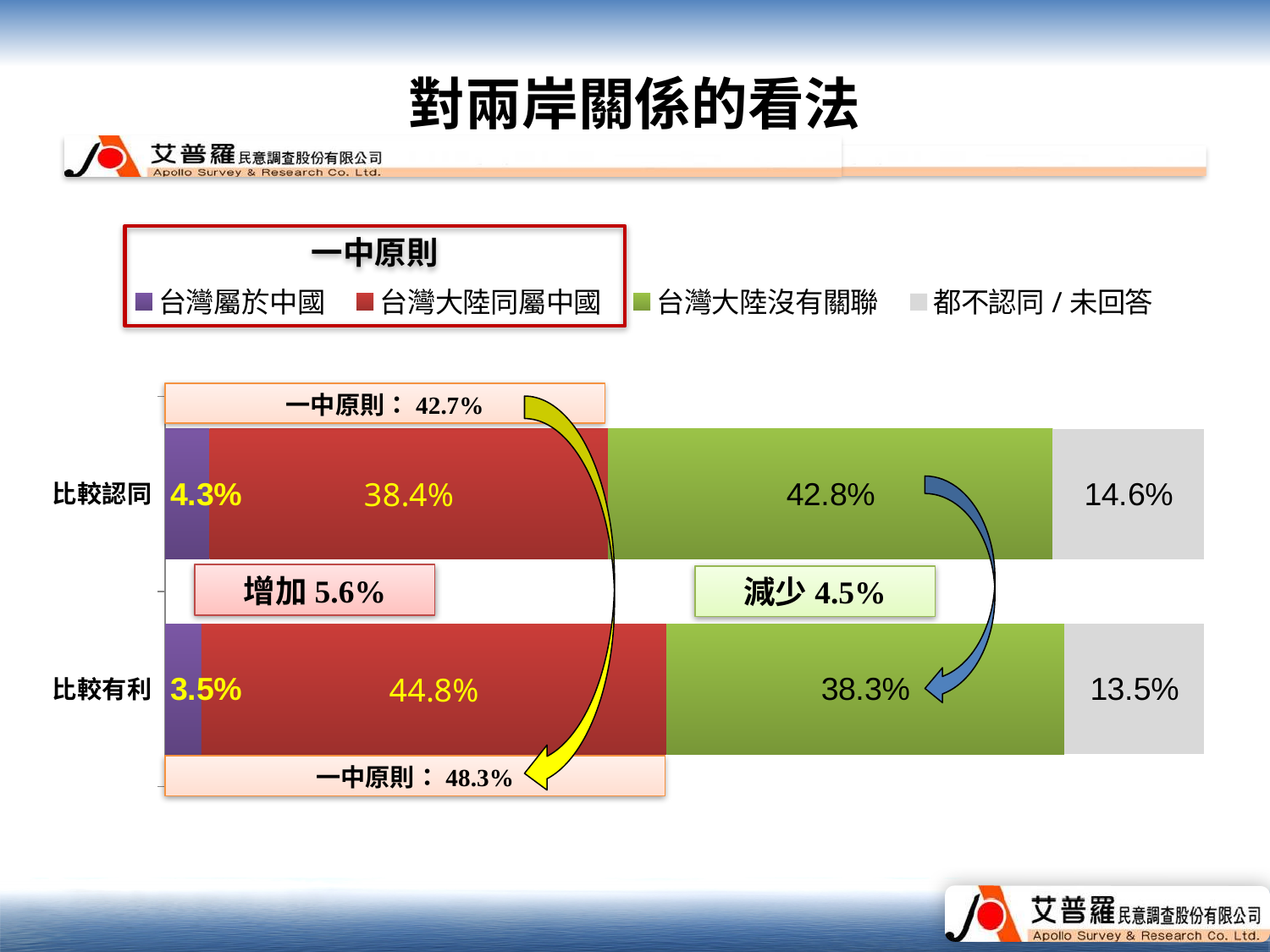
According to the annotation box, what is the 一中原則 total for 比較有利? 48.3% What is the value of 台灣大陸同屬中國 for 比較認同? 38.4% How many categories (bars) are plotted in the chart? 2 What kind of chart is shown on the slide? Stacked bar chart Which is larger: 台灣大陸沒有關聯 for 比較認同 or for 比較有利? 比較認同 How many series does the legend list? 4 What is the value of 台灣屬於中國 for 比較有利? 3.5% What is the value of 都不認同／未回答 for 比較認同? 14.6% What is the difference between the 台灣大陸同屬中國 values for 比較有利 and 比較認同? 6.4% Which series has the highest value in the 比較有利 bar? 台灣大陸同屬中國 Which series has the lowest value in the 比較認同 bar? 台灣屬於中國 What is the value of 台灣大陸沒有關聯 for 比較有利? 38.3%